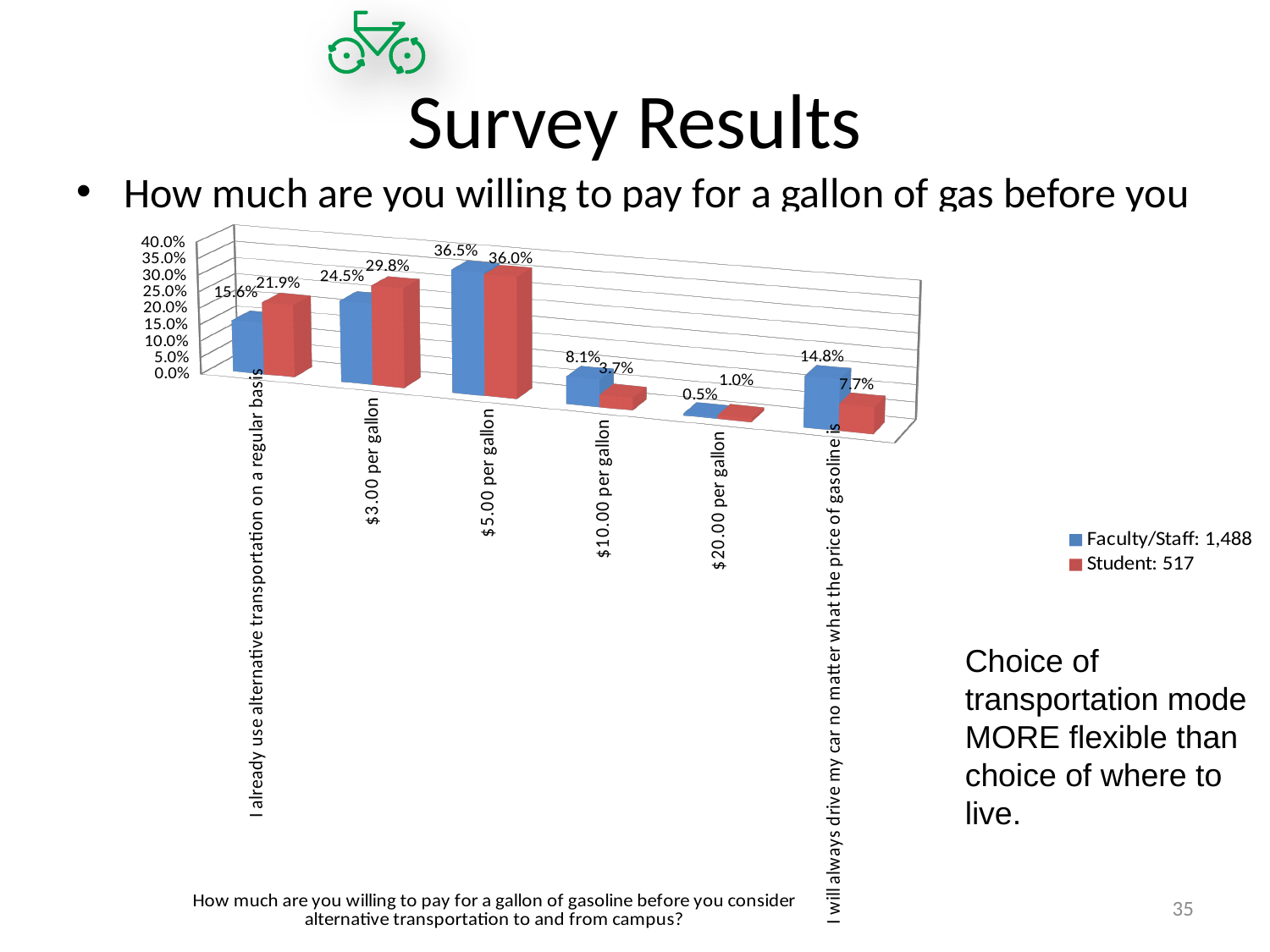
How many series does the chart legend list? 2 What percentage of Faculty/Staff respondents chose "$5.00 per gallon"? 36.5% What is the Student value for "$20.00 per gallon"? 1.0% What percentage of Student respondents chose "$3.00 per gallon"? 29.8% Which category has the lowest value for the Faculty/Staff series? $20.00 per gallon What is the Faculty/Staff value for "I will always drive my car no matter what the price of gasoline is"? 14.8% For "$10.00 per gallon", which series has the larger value, Faculty/Staff or Student? Faculty/Staff How many categories are shown on the x axis of the chart? 6 Which category has the highest value for the Student series? $5.00 per gallon What are the two legend entries of the chart? Faculty/Staff: 1,488 and Student: 517 What kind of chart is shown on the slide? Bar chart What is the difference between the Student and Faculty/Staff values for "I already use alternative transportation on a regular basis"? 6.3%